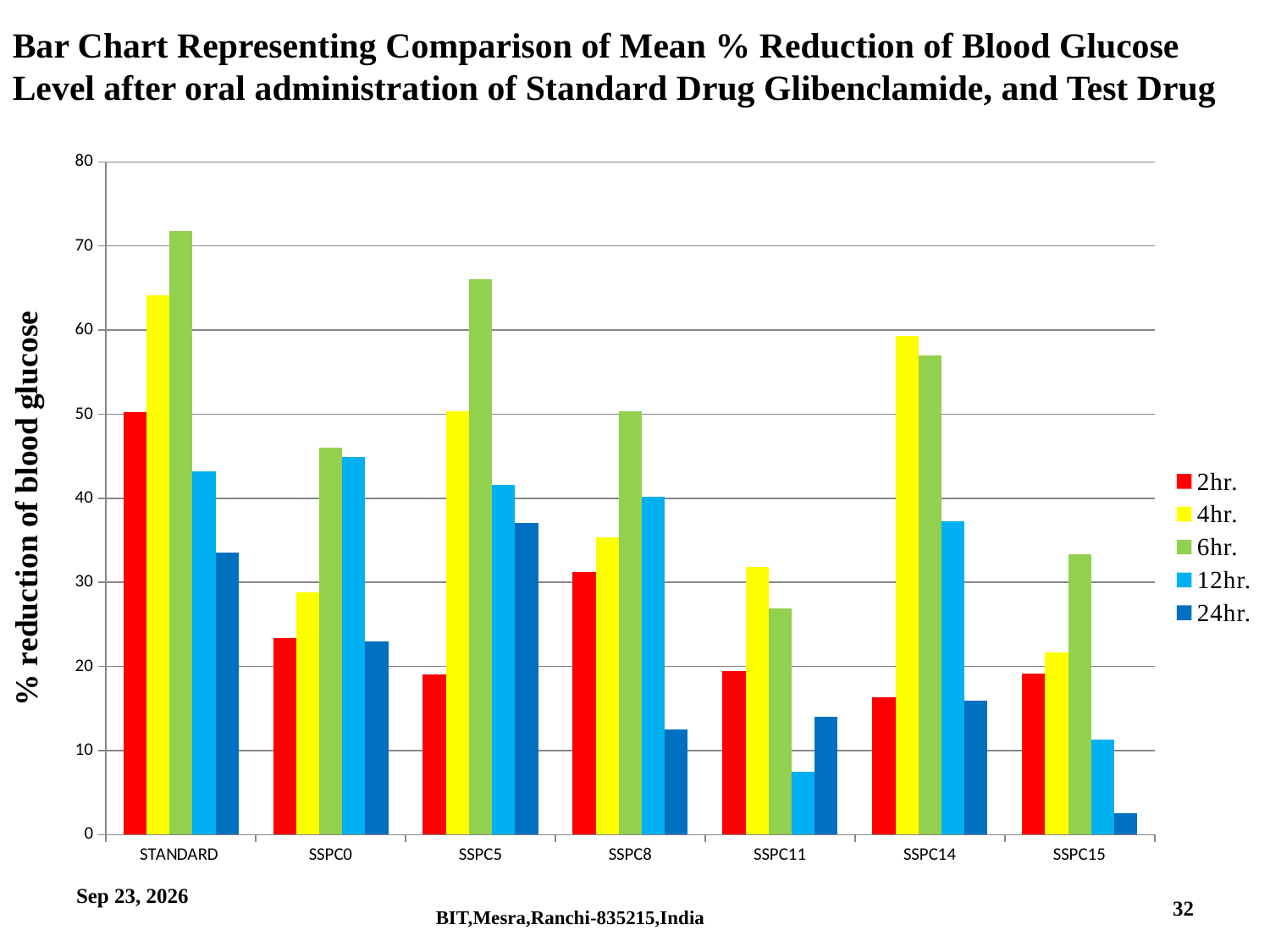
What is the title of the vertical axis? % reduction of blood glucose Is the 4hr. value for SSPC14 greater or less than 50? greater Which category has the lowest value for the 12hr. series? SSPC11 How many categories are shown along the x axis? 7 Is the 6hr. value for STANDARD greater or less than 70? greater How many series does the legend list? 5 Which category has the highest value for the 4hr. series? STANDARD Which category has the lowest value for the 24hr. series? SSPC15 Which is larger, the 6hr. value for SSPC5 or the 6hr. value for SSPC8? SSPC5 What kind of chart is shown on the slide? Bar chart Is the 24hr. value for SSPC15 greater or less than 10? less Which category has the highest value for the 6hr. series? STANDARD